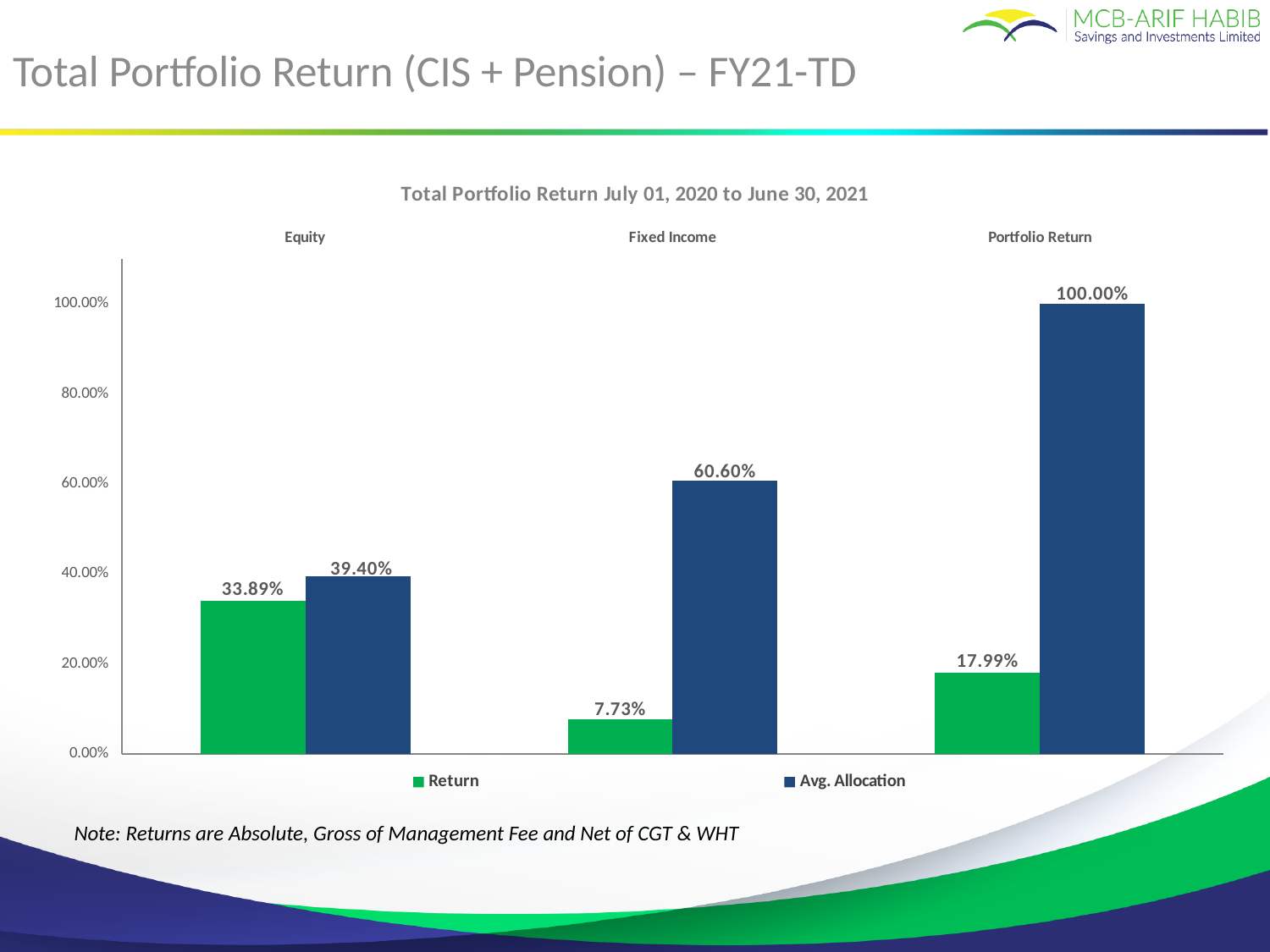
How many series does the legend list? 2 Which is larger: the Return for Equity or the Return for Portfolio Return? Return for Equity What kind of chart is shown on the slide? Bar chart What is the Avg. Allocation value for Fixed Income? 60.60% What is the Return value for Equity? 33.89% Which category has the highest Return value? Equity What is the difference between the Avg. Allocation for Fixed Income and for Equity? 21.20% How many categories are shown on the x axis? 3 Which category has the lowest Return value? Fixed Income What is the Return value for Portfolio Return? 17.99% What is the Avg. Allocation value for Equity? 39.40% What is the title of the chart? Total Portfolio Return July 01, 2020 to June 30, 2021